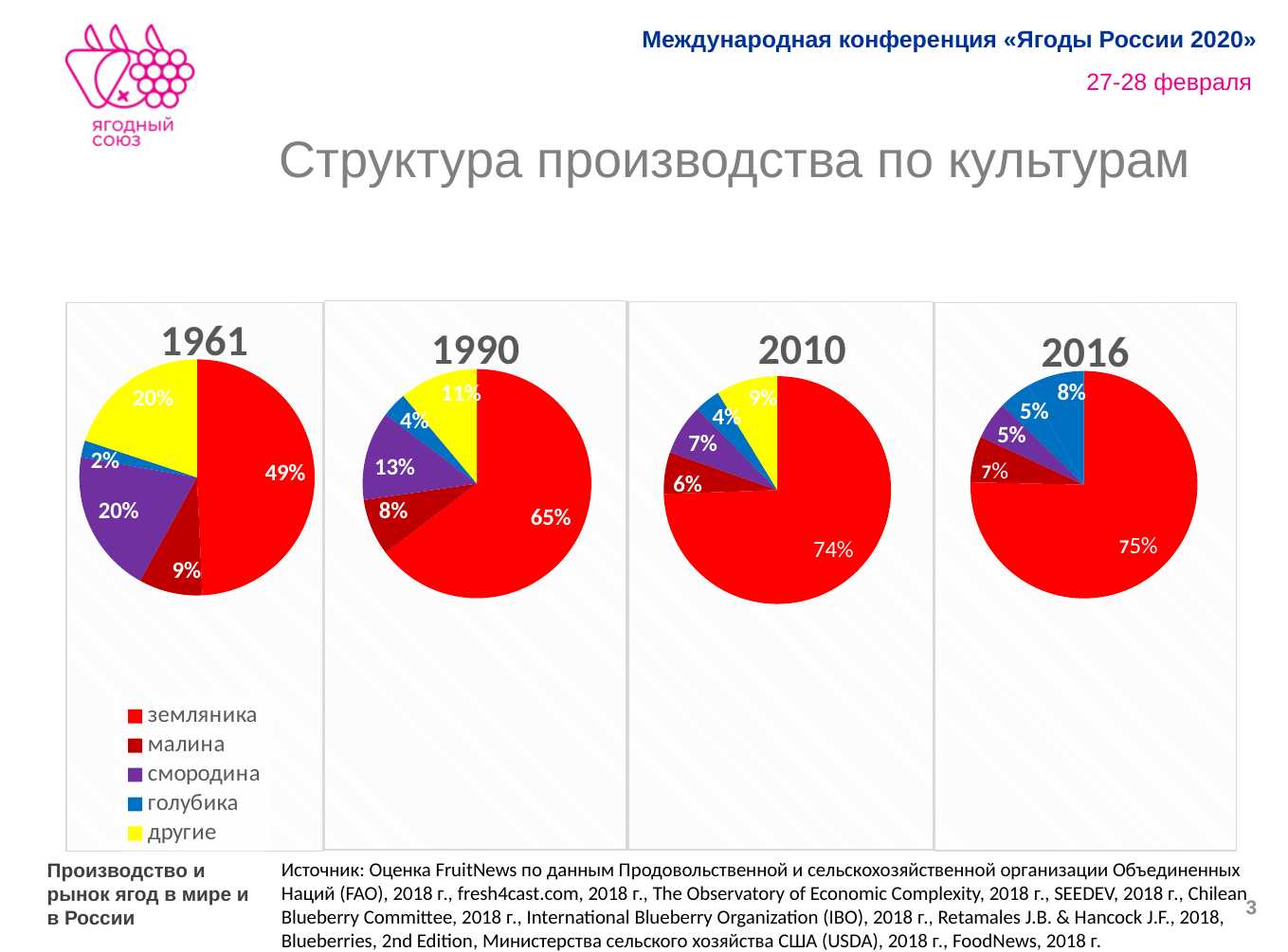
Which colour represents голубика in the legend? Blue What kind of charts are shown on the slide? Pie charts How many series does the legend list? 5 In the 1990 pie chart, what is the difference between the shares of земляника and смородина? 52% In the 2010 pie chart, which category has the largest share? земляника In the 2010 pie chart, what is the value for другие? 9% In the 1961 pie chart, which category has the smallest share? голубика In the 2016 pie chart, which is larger: the share of малина or the share of смородина? малина In the 1990 pie chart, what is the value for смородина? 13% In the 1961 pie chart, what share does земляника have? 49% Does the share of земляника rise or fall from the 1961 chart to the 2016 chart? Rise